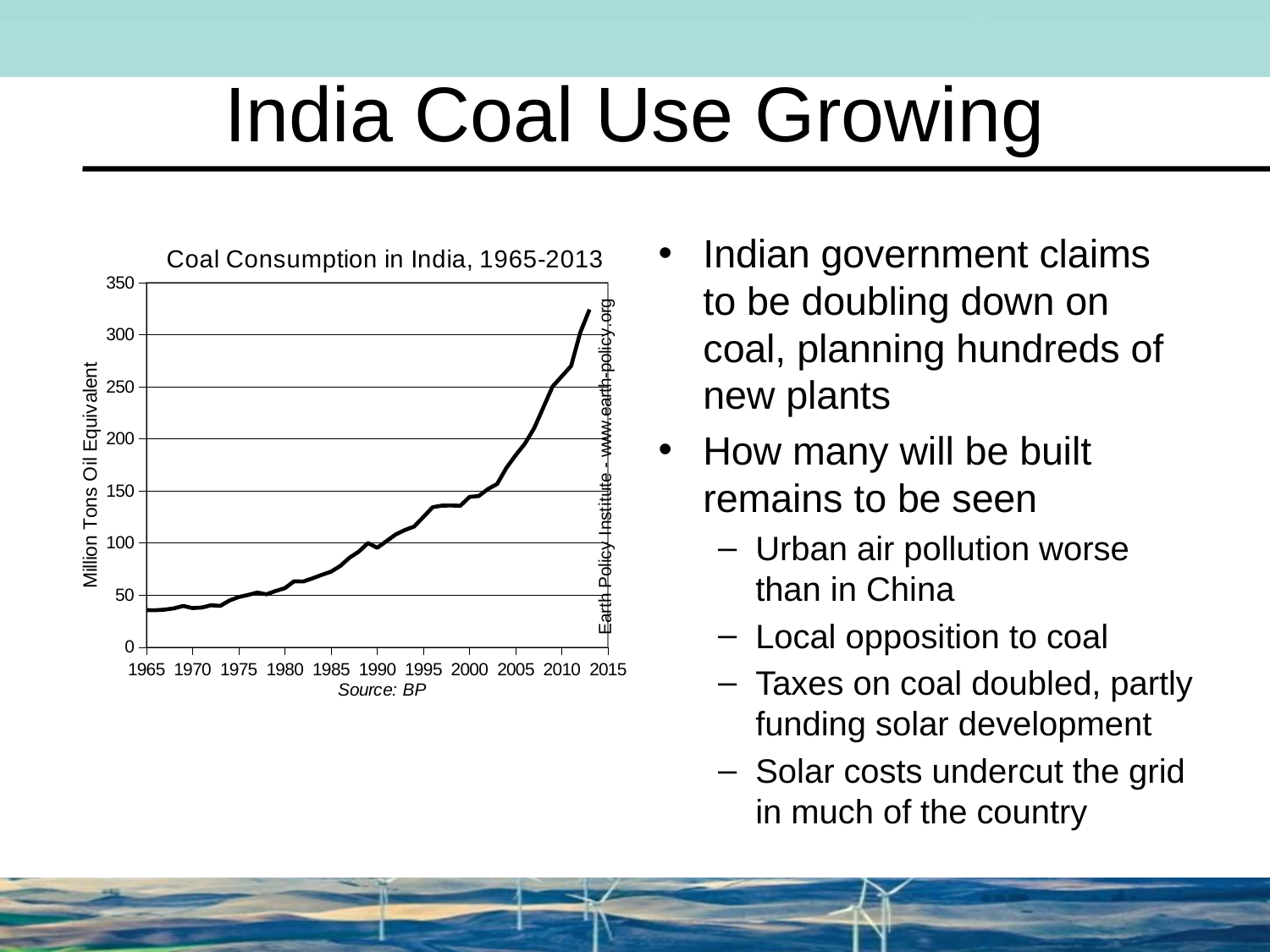
Is the value for 2010 greater or less than 250? greater Which year has the larger coal consumption, 1975 or 2005? 2005 Is the value for 2013 greater or less than 300? greater In which year is coal consumption highest in the chart? 2013 What is the label on the vertical axis of the chart? Million Tons Oil Equivalent Is the value for 1965 greater or less than 50? less What is the title of the chart? Coal Consumption in India, 1965-2013 What kind of chart is shown on the slide? line chart Do the values in the chart generally rise or fall from 1965 to 2013? rise